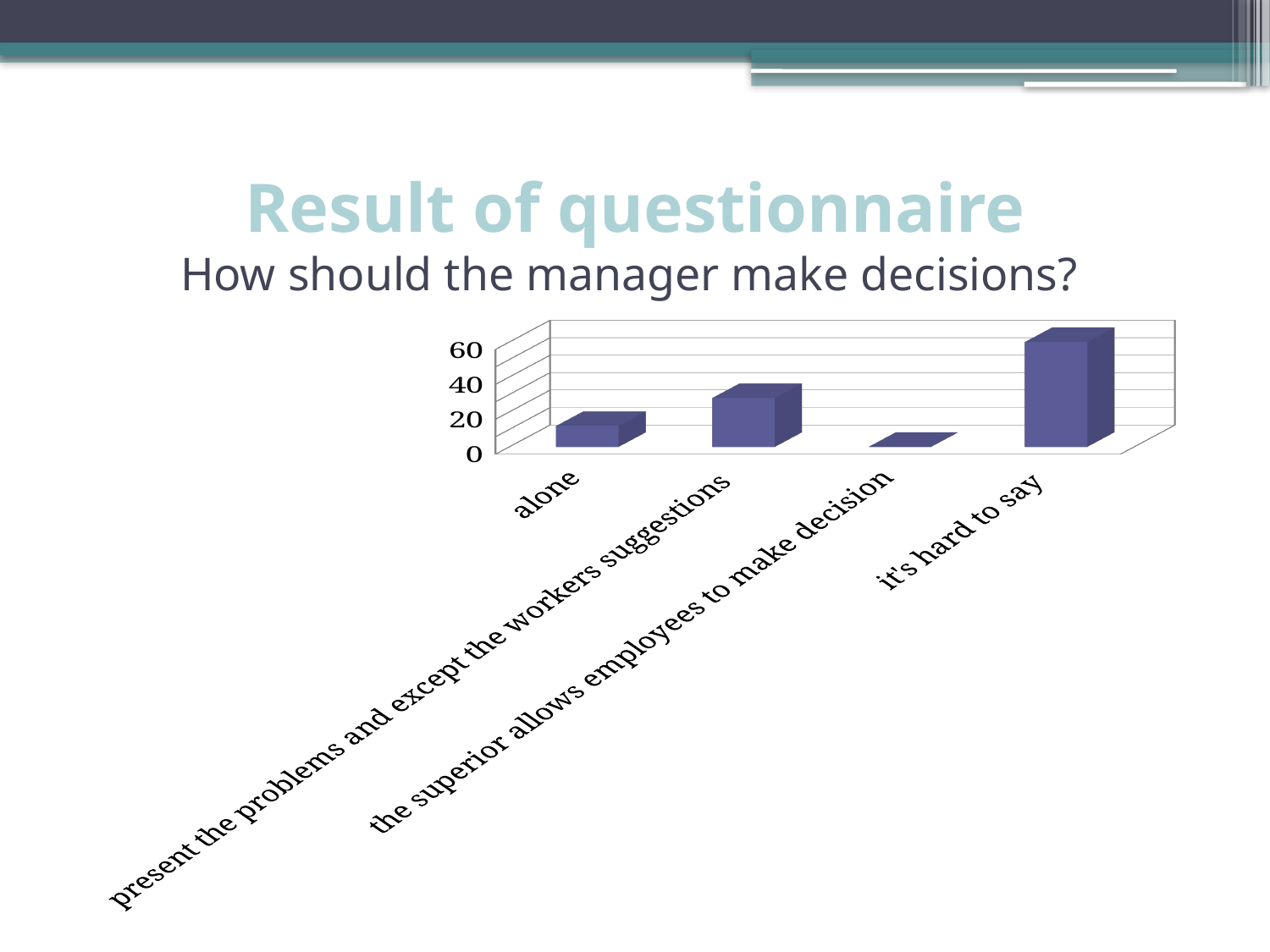
What question does the chart on the slide present results for? How should the manager make decisions? Is the value for "it's hard to say" greater or less than 40? greater Is the value for "alone" greater or less than 20? less Is the value for "present the problems and except the workers suggestions" greater or less than 20? greater Which category has the highest bar in the chart? it's hard to say Which is larger: the value for "it's hard to say" or the value for "present the problems and except the workers suggestions"? it's hard to say How many categories are shown on the x axis of the chart? 4 What is the highest tick value shown on the vertical axis of the chart? 60 Which is larger: the value for "alone" or the value for "present the problems and except the workers suggestions"? present the problems and except the workers suggestions What kind of chart is shown on the slide? bar chart Which category has the lowest bar in the chart? the superior allows employees to make decision